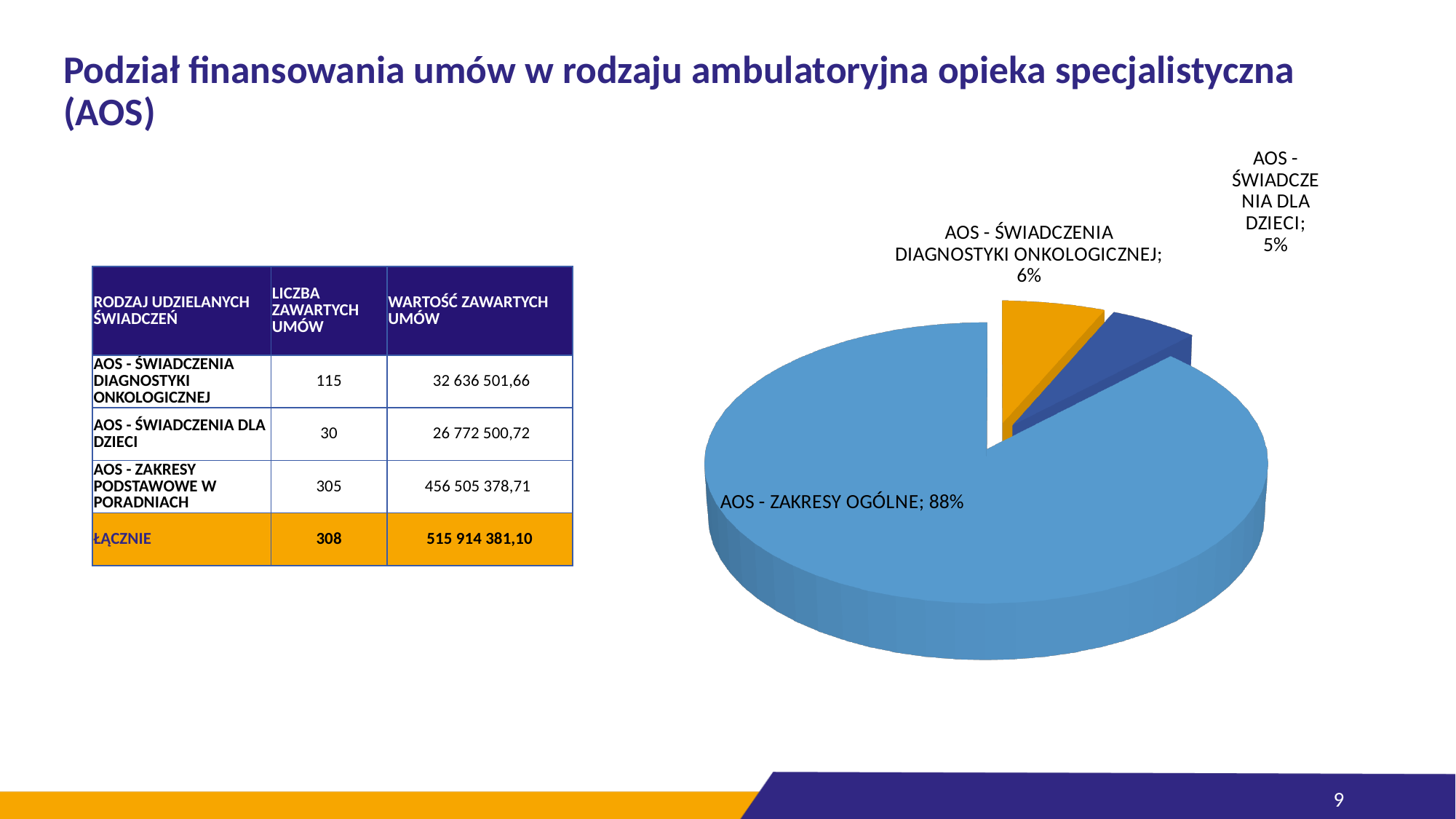
What share of the pie does AOS - ŚWIADCZENIA DIAGNOSTYKI ONKOLOGICZNEJ have? 6% What is the difference in percentage points between the AOS - ŚWIADCZENIA DIAGNOSTYKI ONKOLOGICZNEJ slice and the AOS - ŚWIADCZENIA DLA DZIECI slice? 1 What share of the pie does AOS - ZAKRESY OGÓLNE have? 88% How many slices does the pie chart have? 3 What colour is the AOS - ŚWIADCZENIA DIAGNOSTYKI ONKOLOGICZNEJ slice in the pie chart? orange What share of the pie does AOS - ŚWIADCZENIA DLA DZIECI have? 5% Which slice is larger: AOS - ŚWIADCZENIA DIAGNOSTYKI ONKOLOGICZNEJ or AOS - ŚWIADCZENIA DLA DZIECI? AOS - ŚWIADCZENIA DIAGNOSTYKI ONKOLOGICZNEJ What kind of chart is shown on the slide? pie chart What is the difference in percentage points between the AOS - ZAKRESY OGÓLNE slice and the AOS - ŚWIADCZENIA DIAGNOSTYKI ONKOLOGICZNEJ slice? 82 Which slice of the pie chart is the smallest? AOS - ŚWIADCZENIA DLA DZIECI Which slice of the pie chart is the largest? AOS - ZAKRESY OGÓLNE What colour is the AOS - ZAKRESY OGÓLNE slice in the pie chart? light blue